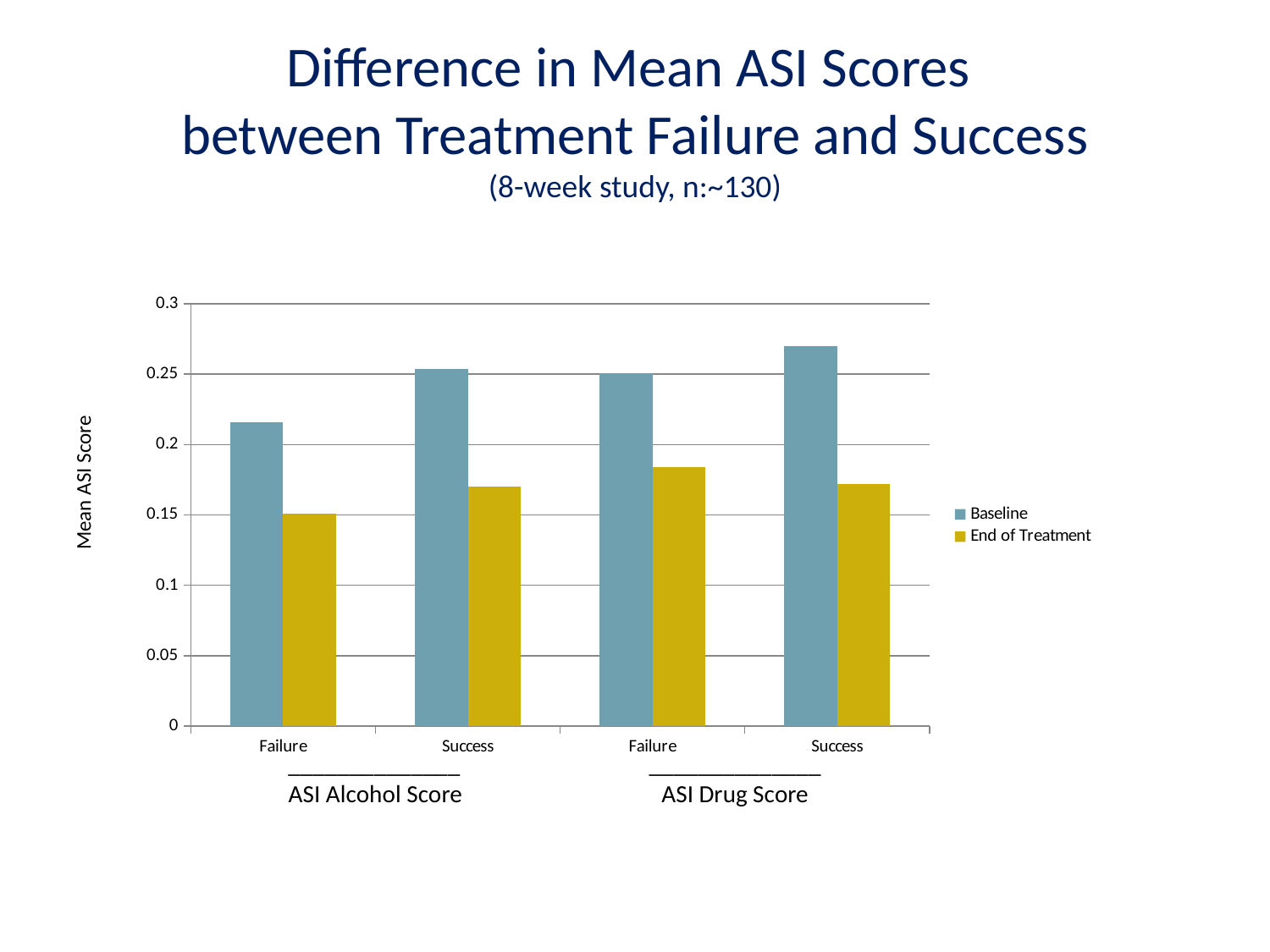
For ASI Alcohol Score Failure, which is larger: the Baseline or the End of Treatment value? Baseline Is the End of Treatment value for ASI Drug Score Failure greater or less than 0.2? less What kind of chart is shown on the slide? Bar chart How many category groups of bars are plotted along the x axis? 4 Is the Baseline value for ASI Alcohol Score Failure greater or less than 0.2? greater How many series does the legend list? 2 Which group has the highest Baseline bar? ASI Drug Score, Success What is the label of the y axis? Mean ASI Score Which series is shown in yellow? End of Treatment Which group has the lowest End of Treatment bar? ASI Alcohol Score, Failure Is the Baseline value for ASI Drug Score Success greater or less than 0.25? greater